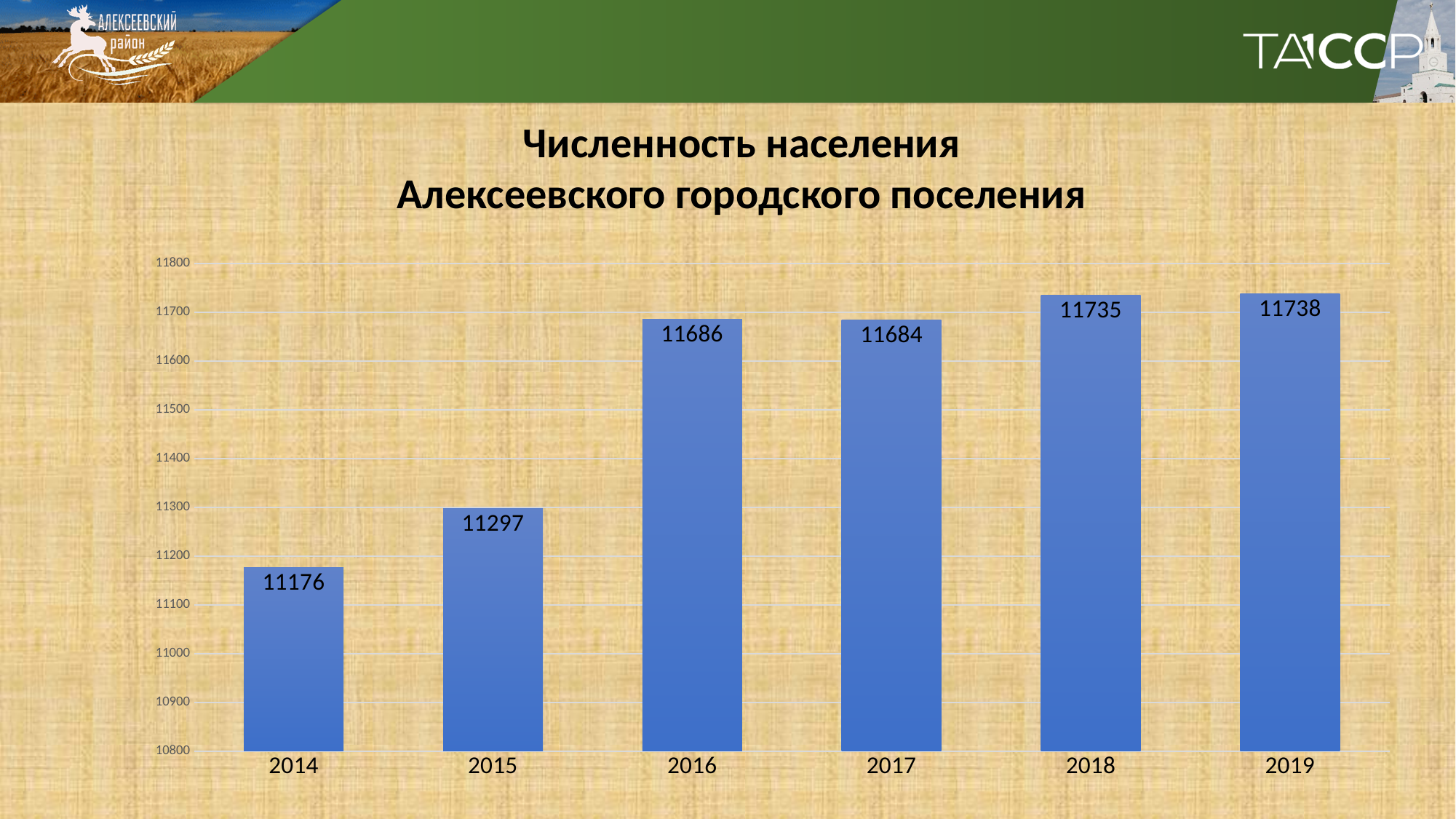
What is the population value shown for 2014? 11176 What is the population value shown for 2017? 11684 What is the population value shown for 2019? 11738 What kind of chart is shown on the slide? bar chart How many years are shown on the x axis? 6 Which is larger, the value for 2015 or the value for 2016? 2016 Do the values generally rise or fall from 2014 to 2019? rise What is the difference between the population values for 2015 and 2014? 121 What is the difference between the population values for 2019 and 2014? 562 Which year has the lowest population value? 2014 Is the value for 2015 greater or less than 11400? less What is the title of the chart? Численность населения Алексеевского городского поселения